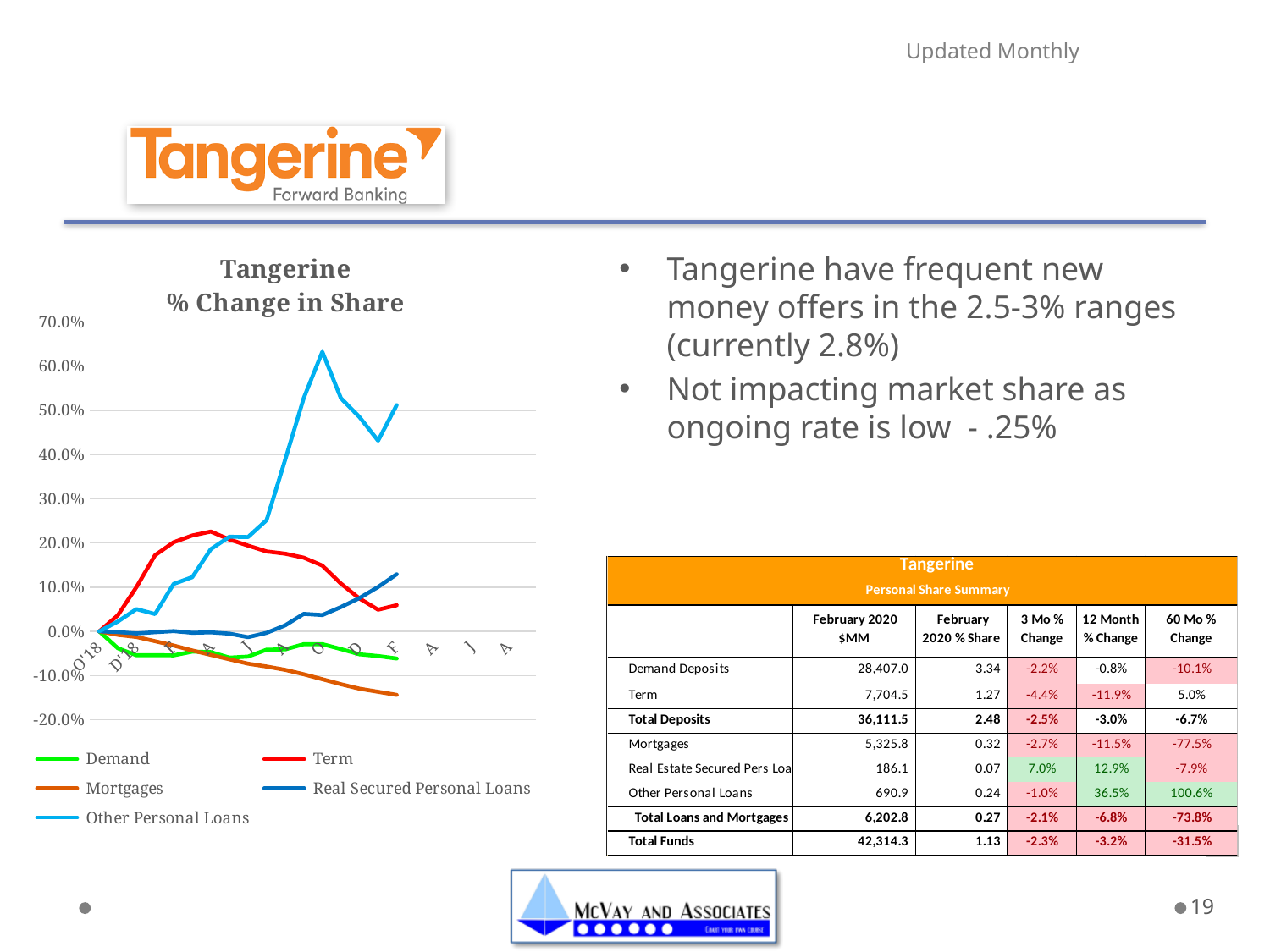
What colour is the line for the Other Personal Loans series? light blue Is the peak value of the Other Personal Loans series greater or less than 50%? greater Is the peak value of the Term series greater or less than 10%? greater What kind of chart is shown on the slide? line chart Which series reaches the highest value on the chart? Other Personal Loans Does the Mortgages series rise or fall along the x axis? fall Which series reaches the lowest value on the chart? Mortgages What is the title of the chart? Tangerine % Change in Share How many series does the legend of the chart list? 5 Does the Other Personal Loans series overall rise or fall from the start of the x axis to its last plotted point? rise At the last plotted point, which series is higher: Term or Demand? Term Is the final plotted value of the Mortgages series greater or less than -10%? less